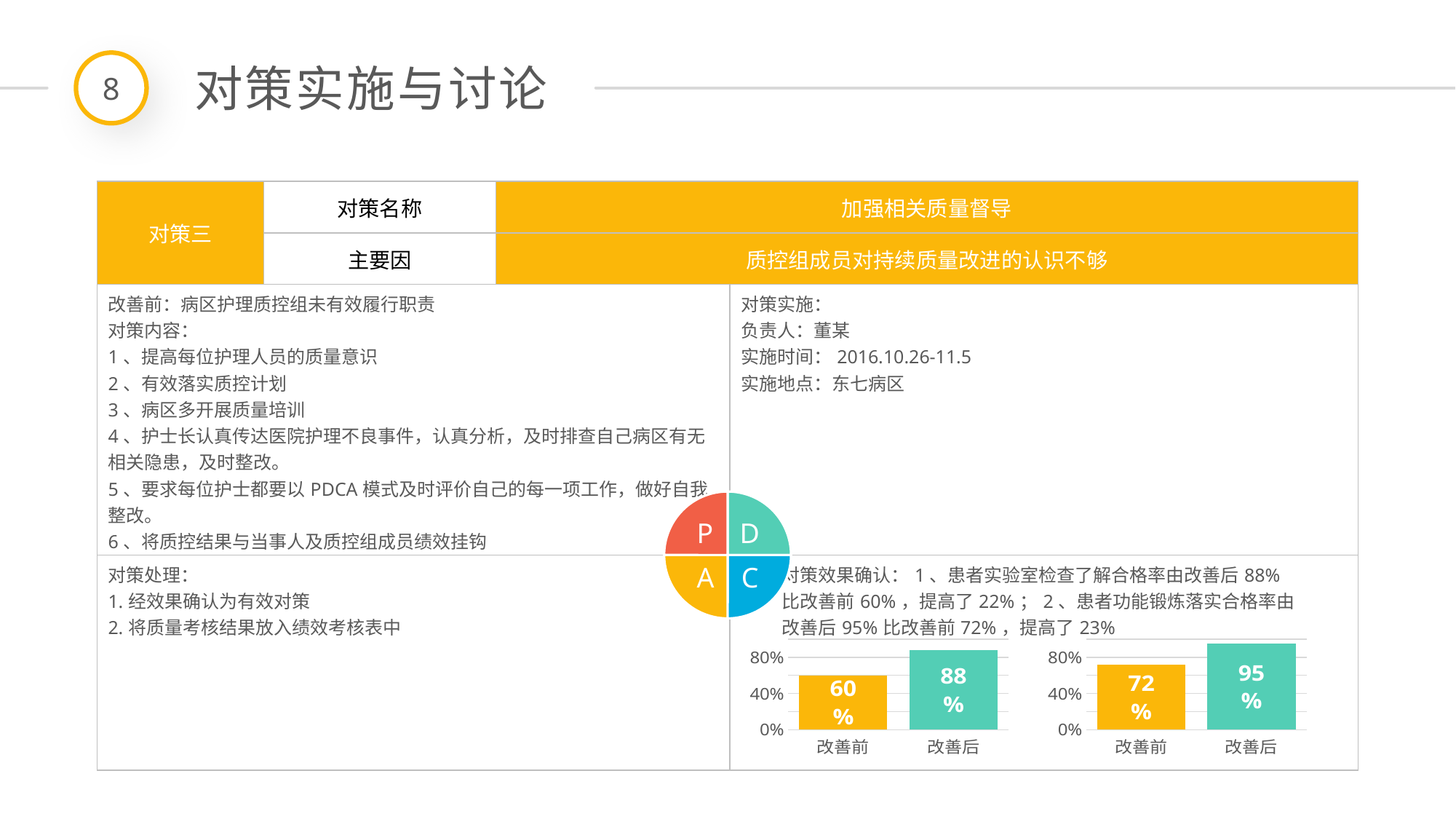
In the left bar chart at the bottom right of the slide, is the value for 改善前 greater or less than 80%? less In the left bar chart at the bottom right of the slide, what is the value for 改善后? 88% In the left bar chart at the bottom right of the slide, what is the difference between the 改善后 and 改善前 values? 28% Is the 改善前 value in the right bar chart larger than the 改善前 value in the left bar chart? Yes In the right bar chart at the bottom right of the slide, what is the difference between the 改善后 and 改善前 values? 23% In the right bar chart at the bottom right of the slide, what is the value for 改善前? 72% How many categories are shown in the right bar chart at the bottom right of the slide? 2 In the left bar chart at the bottom right of the slide, what is the value for 改善前? 60% In the right bar chart at the bottom right of the slide, which category has the lower value? 改善前 In the right bar chart at the bottom right of the slide, what is the value for 改善后? 95% In the left bar chart at the bottom right of the slide, which category has the higher value? 改善后 What type of chart is used at the bottom right of the slide to compare 改善前 and 改善后? Bar chart